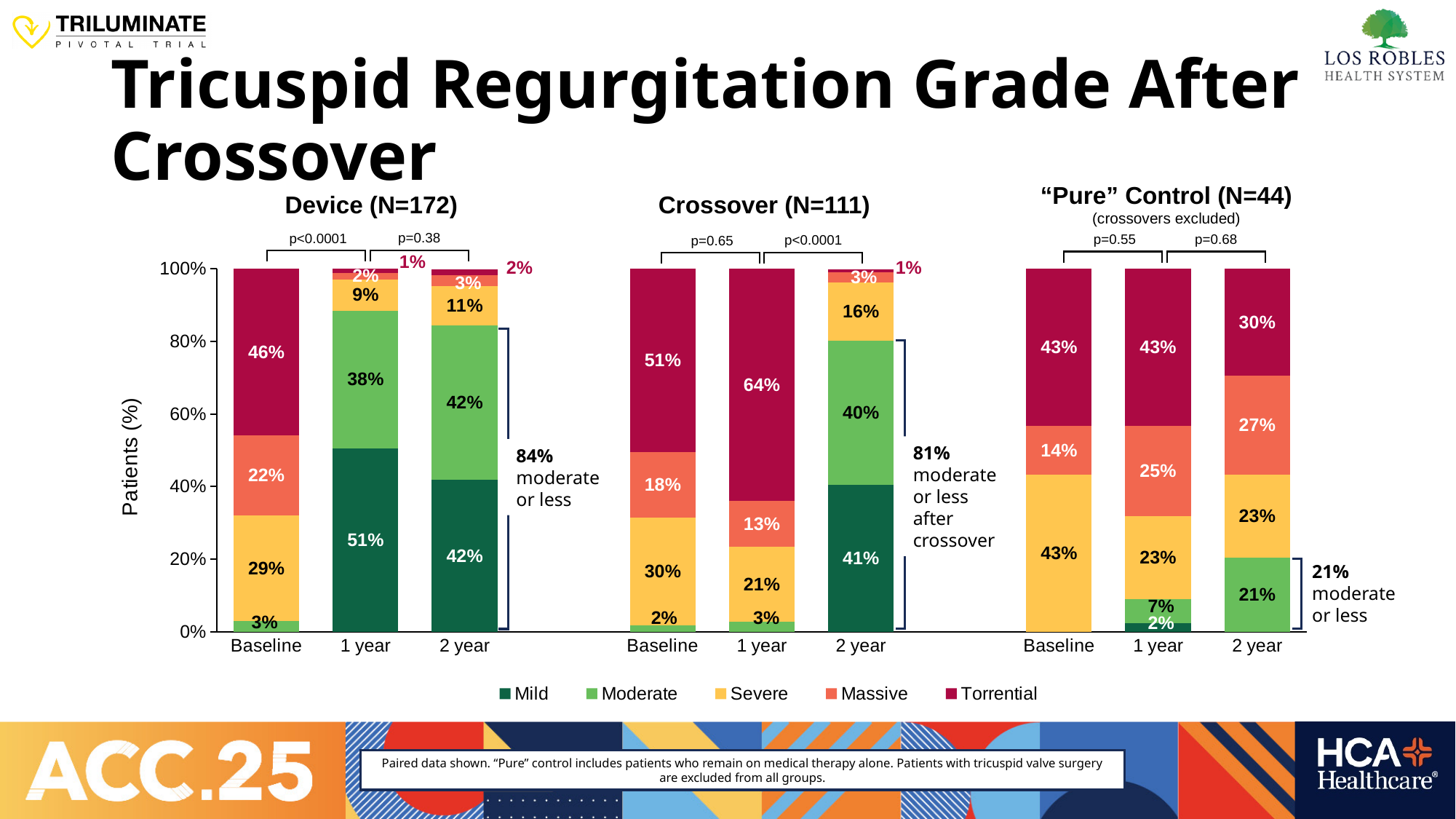
In the Crossover (N=111) chart, what is the combined share of Mild and Moderate patients at 2 year, as annotated on the slide? 81% In the "Pure" Control (N=44) chart, what percentage of patients had Massive regurgitation at 2 year? 27% What type of chart is used for the Device (N=172) panel? Stacked bar chart What is the title of the middle chart on the slide? Crossover (N=111) In the "Pure" Control (N=44) chart, which grade has the smallest share of patients at 1 year? Mild In the Device (N=172) chart, what percentage of patients had Mild tricuspid regurgitation at 1 year? 51% How many regurgitation grades does the shared legend list? 5 In the Device (N=172) chart, what is the difference between the Torrential share at Baseline and the Torrential share at 2 year? 44% In the Crossover (N=111) chart, what percentage of patients had Torrential regurgitation at 1 year? 64% How many time points are shown on the x axis of the Crossover (N=111) chart? 3 Is the Severe share at Baseline larger in the Device (N=172) chart or in the "Pure" Control (N=44) chart? "Pure" Control (N=44) In the Crossover (N=111) chart, which grade has the largest share of patients at 2 year? Mild